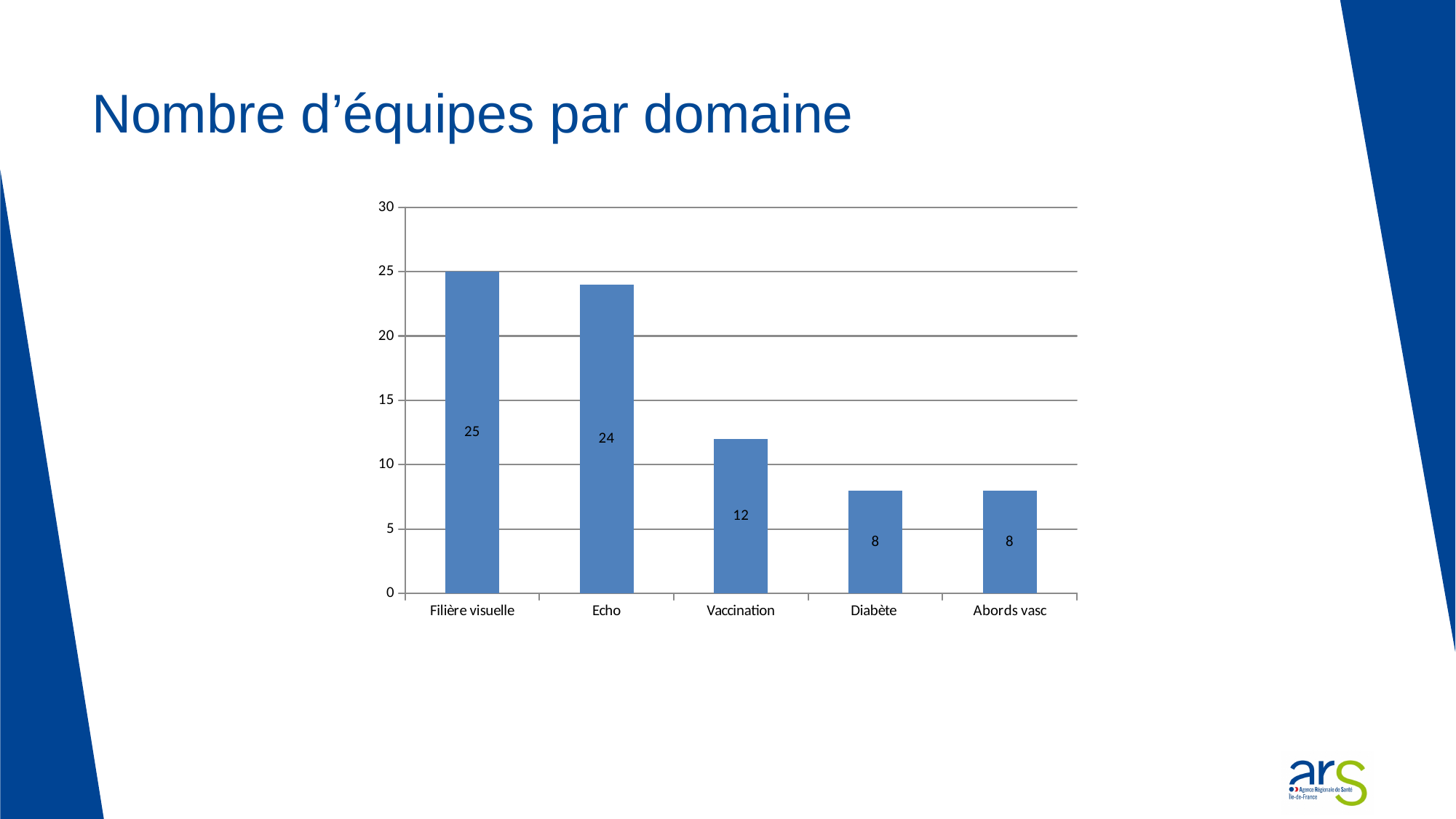
What is the difference between the values for Echo and Diabète? 16 What is the value for Filière visuelle? 25 What kind of chart is shown on the slide? bar chart How many categories are shown on the x axis? 5 What is the difference between the values for Filière visuelle and Vaccination? 13 What is the value for Echo? 24 What is the title of the slide? Nombre d’équipes par domaine Is the value for Vaccination greater or less than 10? greater What is the value for Vaccination? 12 Which category has the highest value? Filière visuelle Which is larger, the value for Echo or the value for Vaccination? Echo What is the value for Diabète? 8